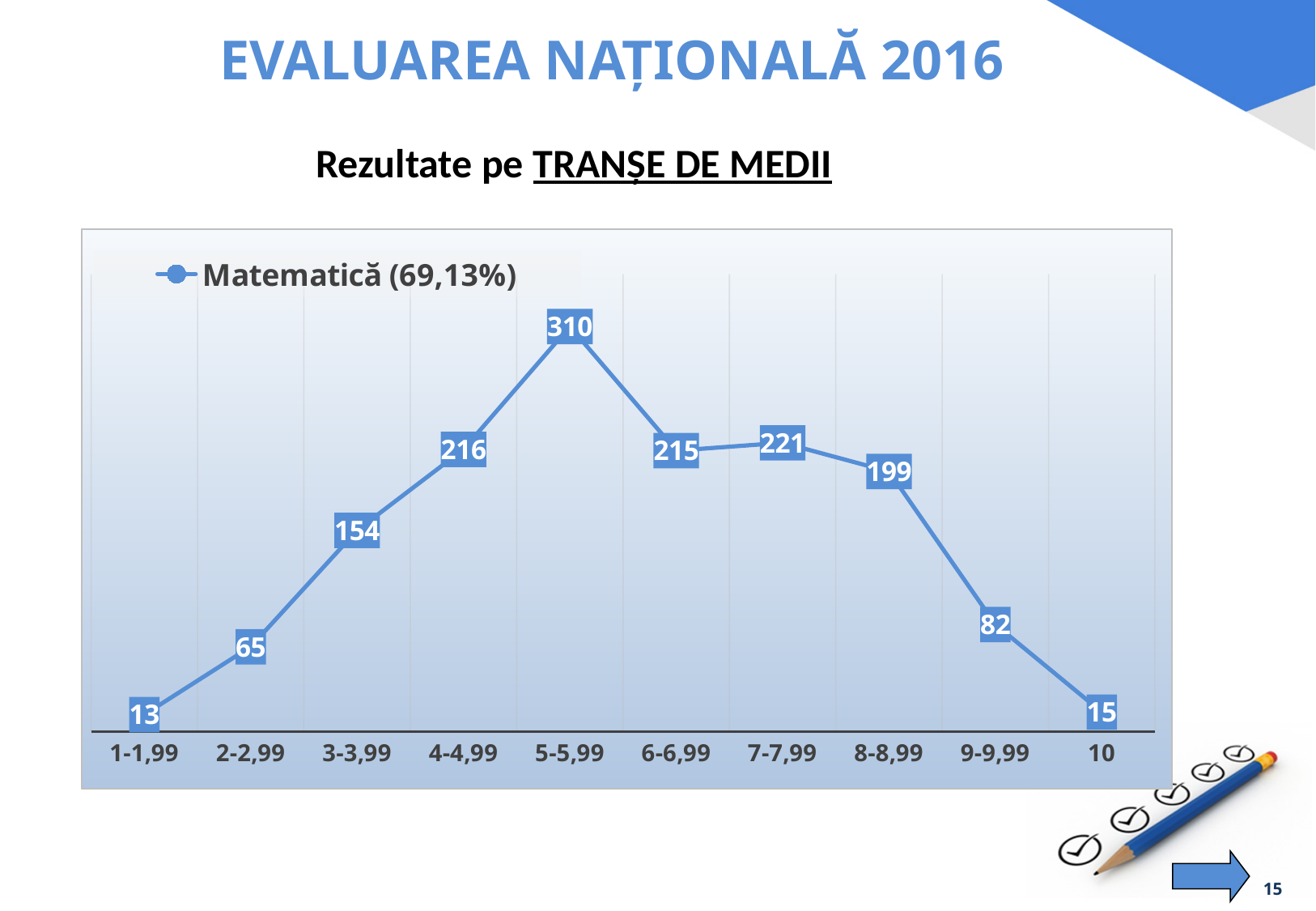
Which grade band has the lowest value? 1-1,99 Which is larger, the value for 6-6,99 or the value for 7-7,99? 7-7,99 What is the value for the 10 grade band? 15 Which grade band has the highest value? 5-5,99 How many series does the legend list? 1 What is the value for the 5-5,99 grade band? 310 What is the difference between the values for 8-8,99 and 9-9,99? 117 What is the value for the 3-3,99 grade band? 154 What is the legend entry for the series shown? Matematică (69,13%) What is the difference between the values for 5-5,99 and 4-4,99? 94 How many grade bands are shown on the x axis? 10 What kind of chart is shown on the slide? line chart